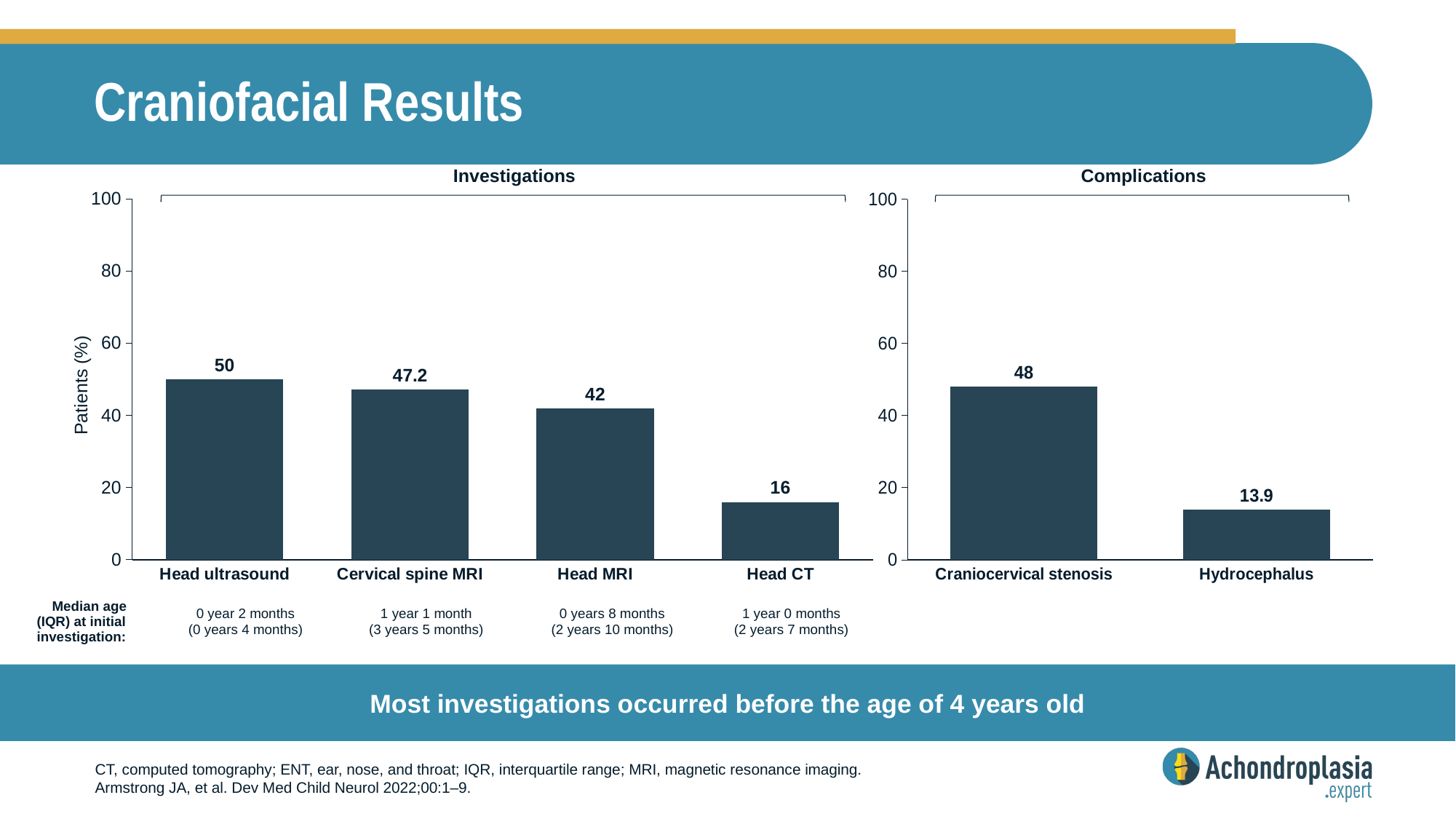
In the Investigations chart, is the value for Head MRI greater or less than 40? greater In the Complications chart, what percentage of patients had hydrocephalus? 13.9 What is the label on the y axis of the Investigations chart? Patients (%) In the Investigations chart, what percentage of patients had a head ultrasound? 50 In the Investigations chart, what is the difference between the values for Head MRI and Head CT? 26 In the Investigations chart, which investigation has the lowest percentage of patients? Head CT What type of chart is used for the Complications data? Bar chart In the Investigations chart, which investigation has the highest percentage of patients? Head ultrasound How many investigation categories are shown in the Investigations chart? 4 In the Complications chart, what is the difference between the values for Craniocervical stenosis and Hydrocephalus? 34.1 In the Complications chart, which complication has the higher value? Craniocervical stenosis In the Investigations chart, what is the value for Cervical spine MRI? 47.2